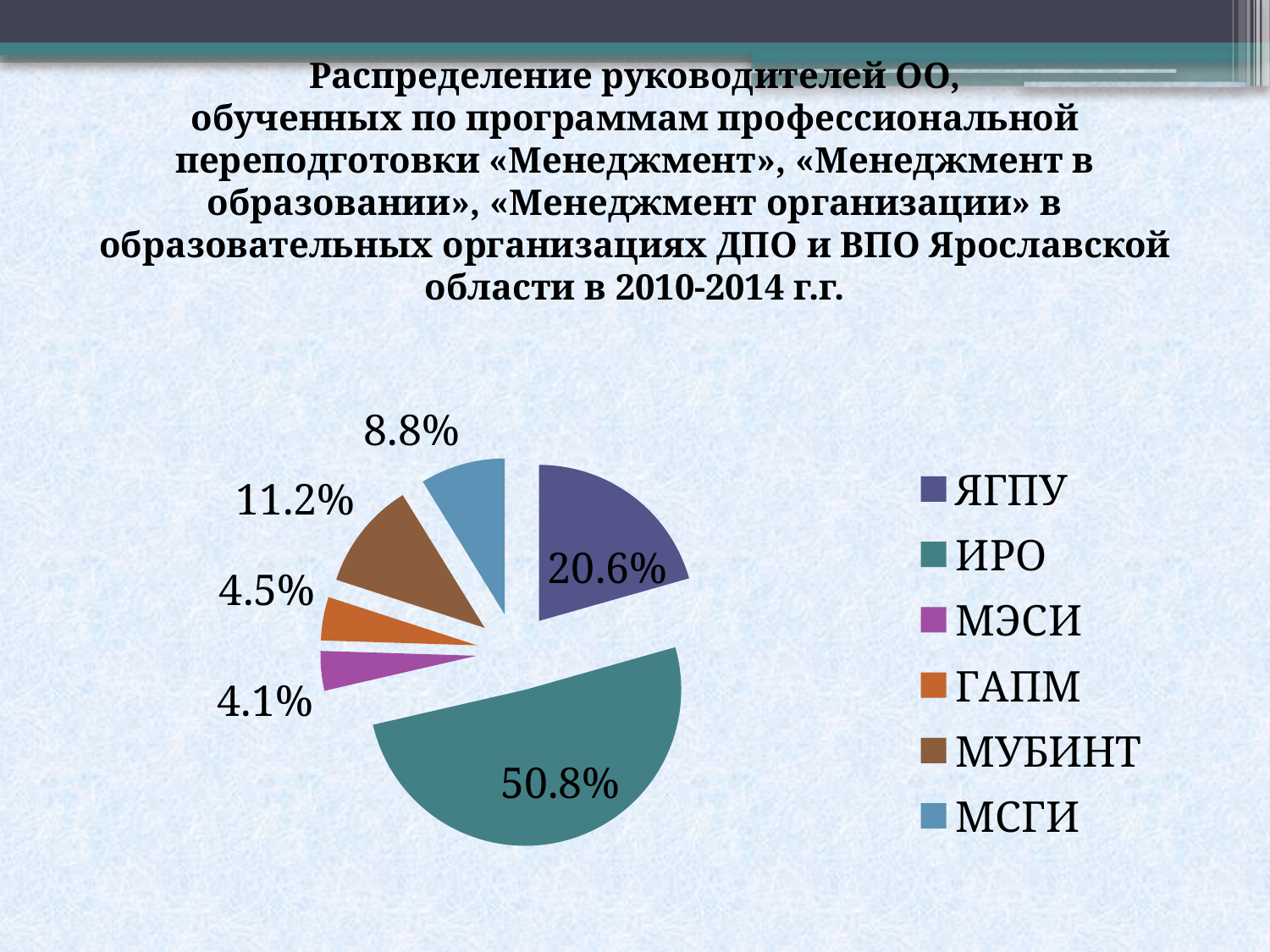
What share of the pie does ЯГПУ have? 20.6% What share of the pie does МЭСИ have? 4.1% What share of the pie does ГАПМ have? 4.5% What is the difference in percentage points between the ИРО slice and the ЯГПУ slice? 30.2 What share of the pie does ИРО have? 50.8% Which organisation has the smallest slice of the pie? МЭСИ Which organisation has the largest slice of the pie? ИРО Which slice is larger, МУБИНТ or МСГИ? МУБИНТ How many organisations are listed in the legend? 6 What share of the pie does МУБИНТ have? 11.2% What type of chart is shown on the slide? pie chart What share of the pie does МСГИ have? 8.8%